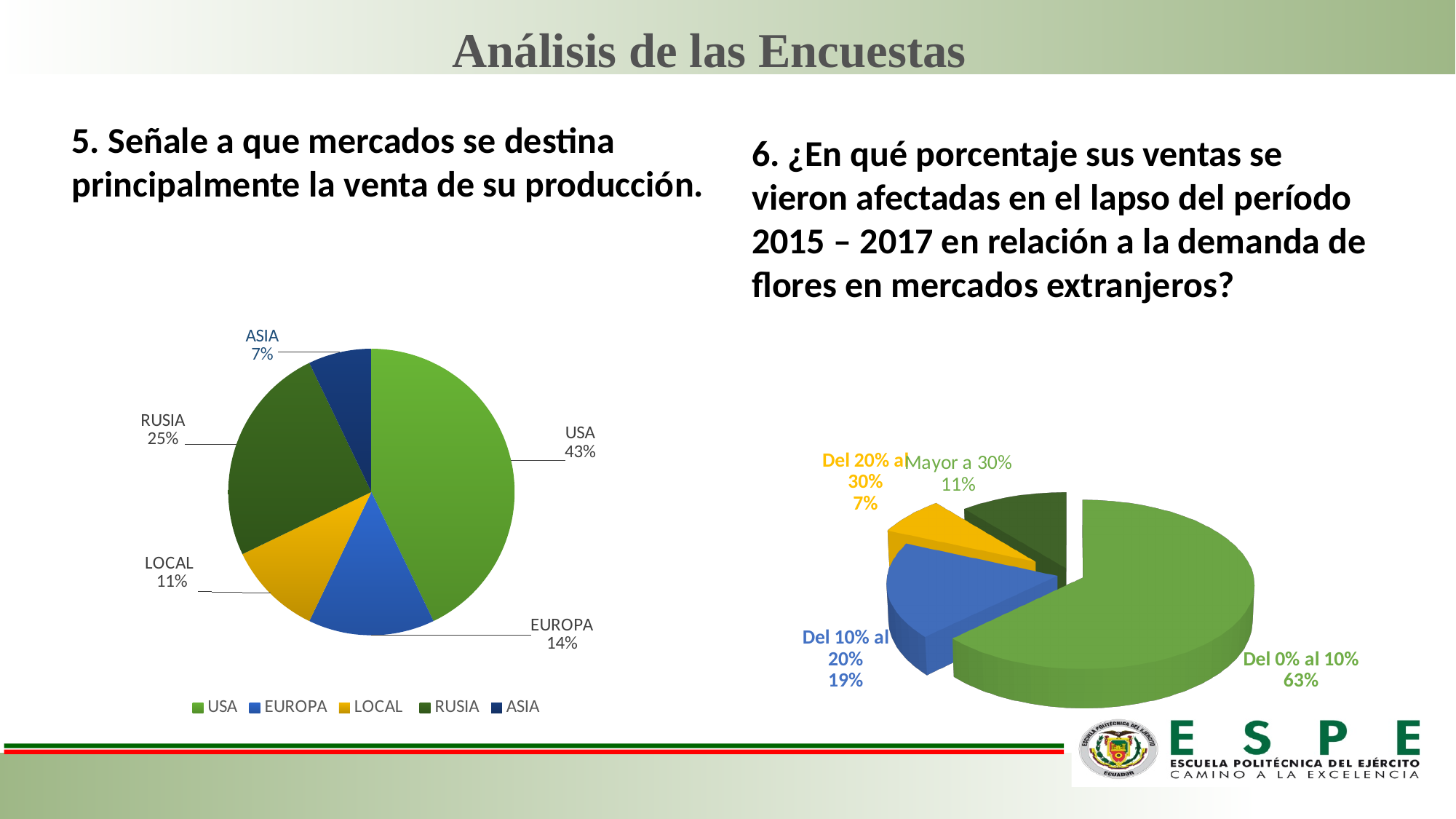
In the right pie chart (question 6), what percentage is shown for 'Del 10% al 20%'? 19% In the left pie chart (question 5), which is larger, the LOCAL slice or the EUROPA slice? EUROPA In the left pie chart (question 5), which market has the smallest slice? ASIA How many categories does the legend of the left pie chart (question 5) list? 5 What type of chart is used for question 5 on the left of the slide? Pie chart In the right pie chart (question 6), what percentage is shown for 'Del 0% al 10%'? 63% In the left pie chart (question 5), what percentage is shown for RUSIA? 25% In the right pie chart (question 6), which category has the smallest slice? Del 20% al 30% In the left pie chart (question 5), what is the difference in percentage points between USA and EUROPA? 29 In the left pie chart (question 5), which market has the largest slice? USA In the right pie chart (question 6), what is the difference in percentage points between 'Mayor a 30%' and 'Del 20% al 30%'? 4 In the left pie chart (question 5), what share of the pie does USA have? 43%